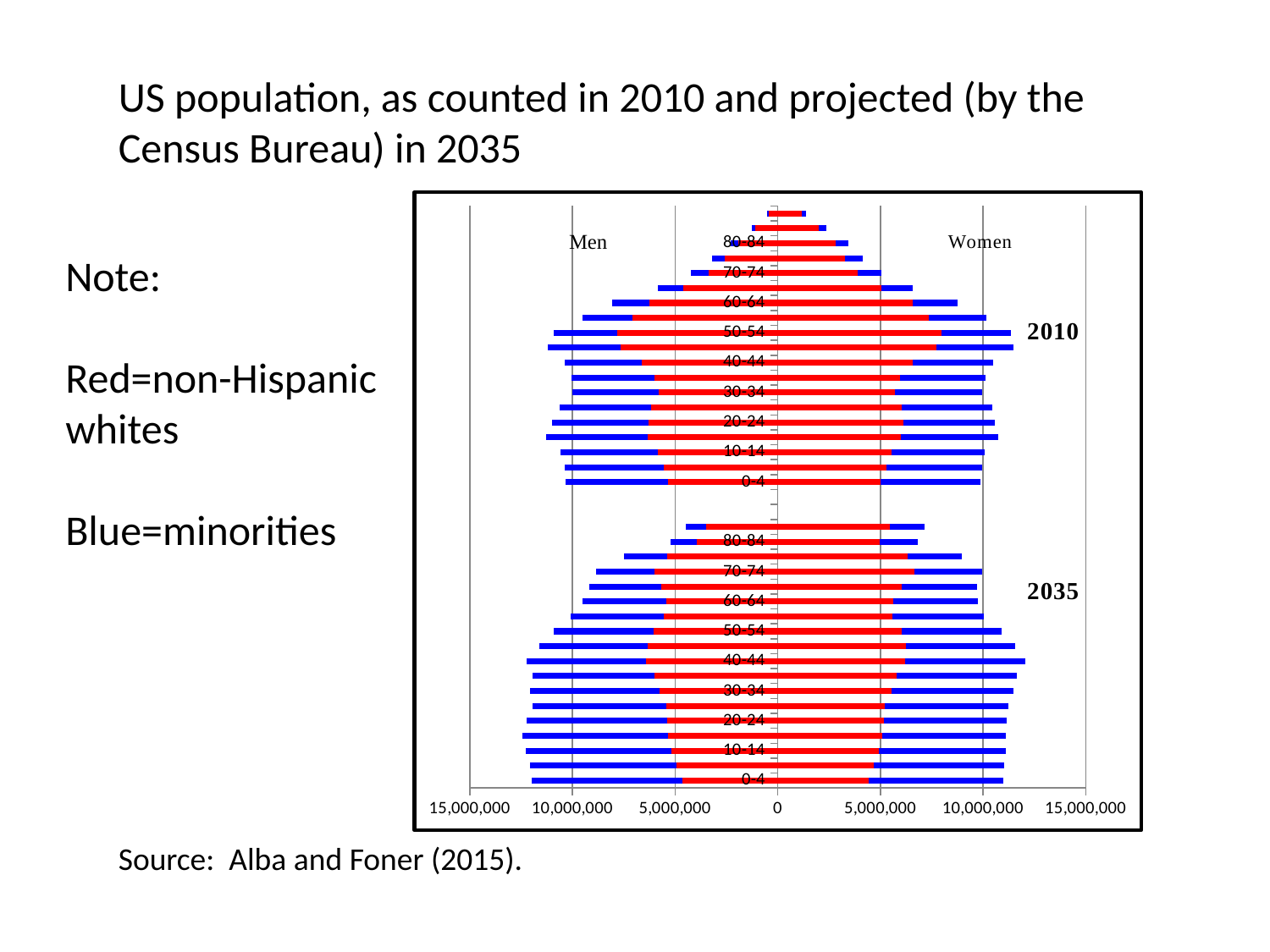
In the 2035 panel, do the bars for women get shorter or longer going from the 40-44 age group up to the 80-84 age group? shorter In the 2035 panel, is the total bar for men aged 40-44 greater or less than 10,000,000? greater Which is larger: the total bar for women aged 80-84 in 2010 or in 2035? 2035 In the 2035 panel, is the total bar for women aged 80-84 greater or less than 5,000,000? greater In the 2010 panel, is the total bar for men aged 60-64 greater or less than 10,000,000? less What is the largest value labeled on the horizontal axis? 15,000,000 According to the note on the slide, what do the red portions of the bars represent? non-Hispanic whites What kind of chart is shown on the slide? bar chart How many age-group labels are printed on the 2010 panel of the chart? 9 Which side of the chart shows men, the left or the right? left